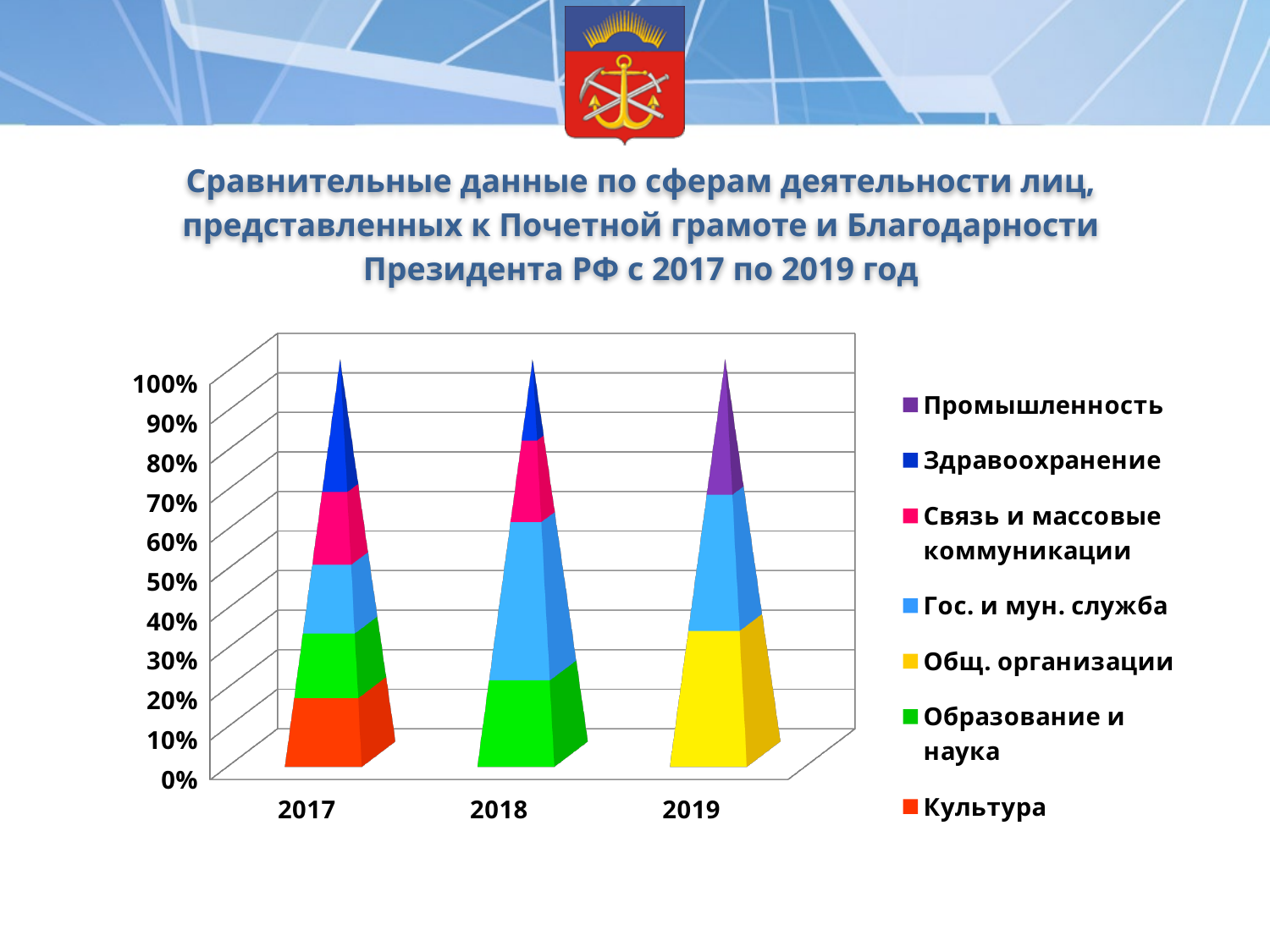
In 2018, which segment is larger: Гос. и мун. служба or Здравоохранение? Гос. и мун. служба Is the value for Образование и наука in 2018 greater or less than 40%? less Is the value for Гос. и мун. служба in 2018 greater or less than 20%? greater What kind of chart is shown on the slide? Stacked bar chart Which series appears in the 2019 bar but in neither the 2017 nor the 2018 bar? Промышленность Is the value for Здравоохранение in 2017 greater or less than 50%? less How many years (categories) are shown on the x axis of the chart? 3 Which legend entry is shown in yellow? Общ. организации How many series does the chart legend list? 7 Which years are shown on the x axis of the chart? 2017, 2018, 2019